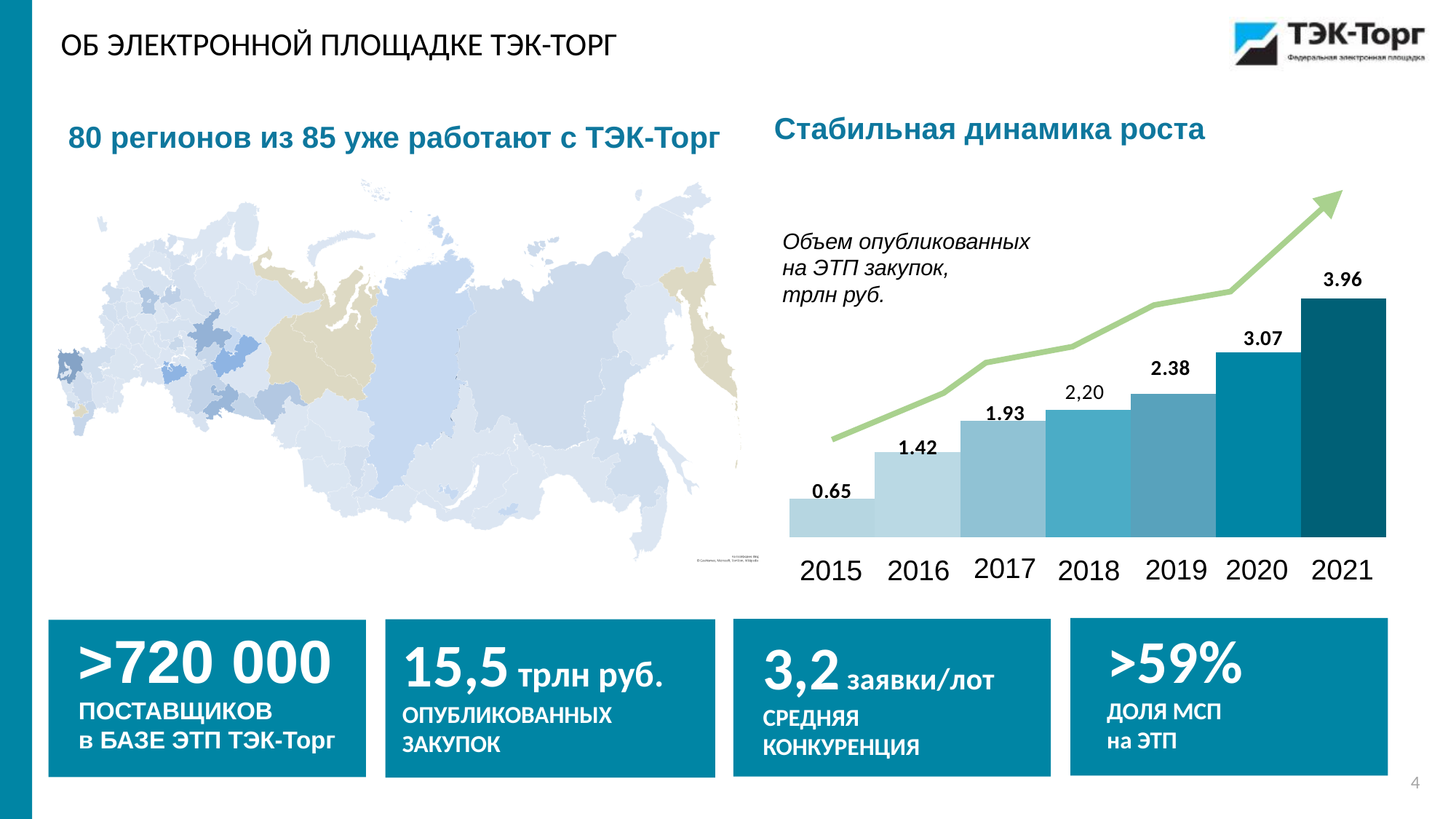
What is the value for 2019 in the bar chart? 2.38 What is the difference between the values for 2016 and 2015 in the bar chart? 0.77 What is the value for 2015 in the bar chart? 0.65 Which is larger in the bar chart, the value for 2017 or the value for 2020? 2020 What is the value for 2021 in the bar chart? 3.96 Which year has the lowest value in the bar chart? 2015 Do the values in the bar chart rise or fall from 2015 to 2021? rise How many years are shown on the x axis of the bar chart? 7 What kind of chart is shown on the right side of the slide? bar chart What is the value for 2018 in the bar chart? 2,20 Which year has the highest value in the bar chart? 2021 What is the difference between the values for 2021 and 2020 in the bar chart? 0.89